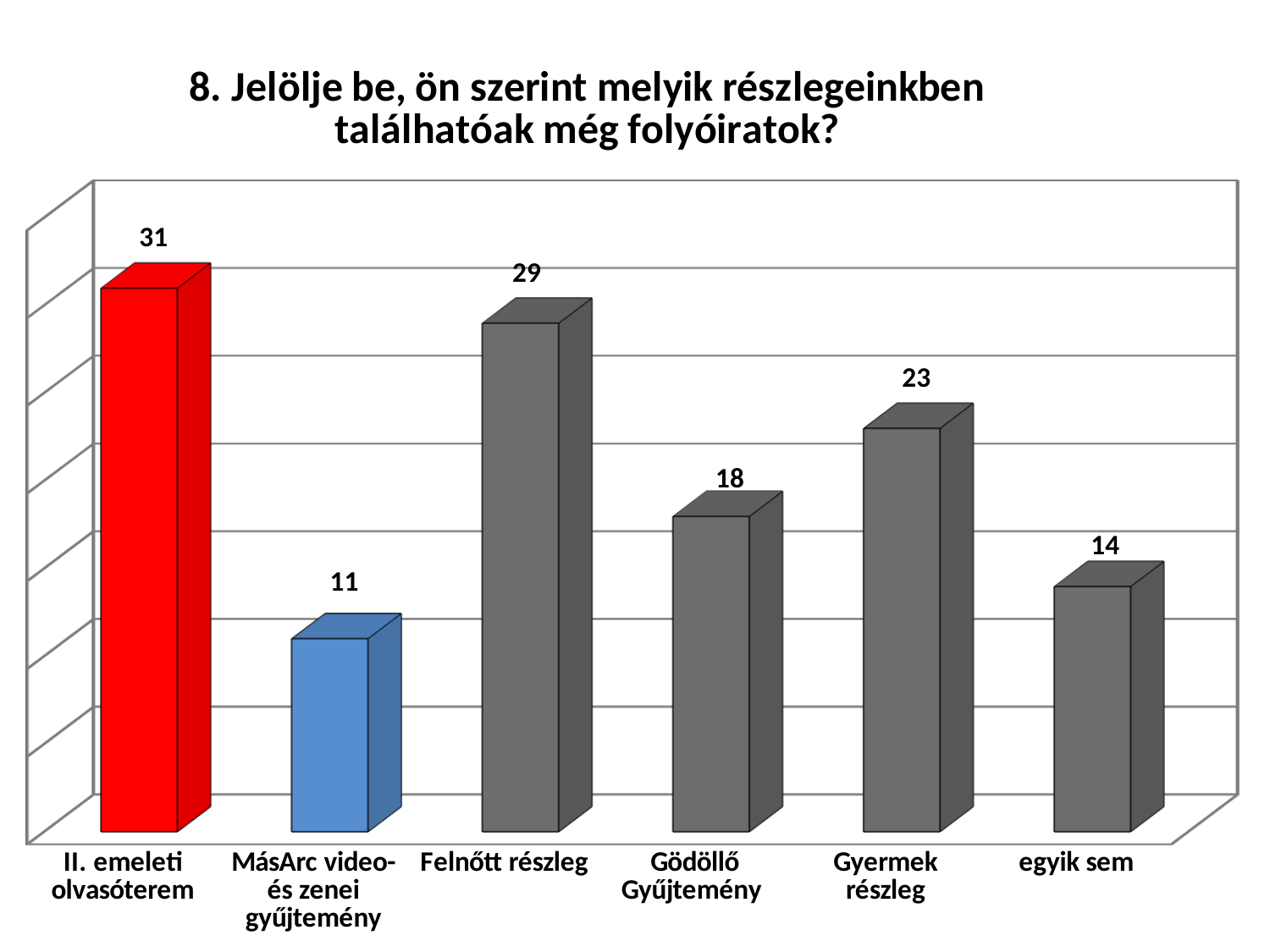
What is the value for Felnőtt részleg? 29 What is the difference between the values for Gyermek részleg and egyik sem? 9 What is the value for II. emeleti olvasóterem? 31 What colour is the bar for MásArc video- és zenei gyűjtemény? blue Which is larger, the value for Gyermek részleg or the value for Gödöllő Gyűjtemény? Gyermek részleg What is the value for egyik sem? 14 What is the value for Gödöllő Gyűjtemény? 18 What kind of chart is shown on the slide? bar chart Which category has the highest value? II. emeleti olvasóterem How many categories are shown in the chart? 6 Which category has the lowest value? MásArc video- és zenei gyűjtemény What is the difference between the values for II. emeleti olvasóterem and Felnőtt részleg? 2